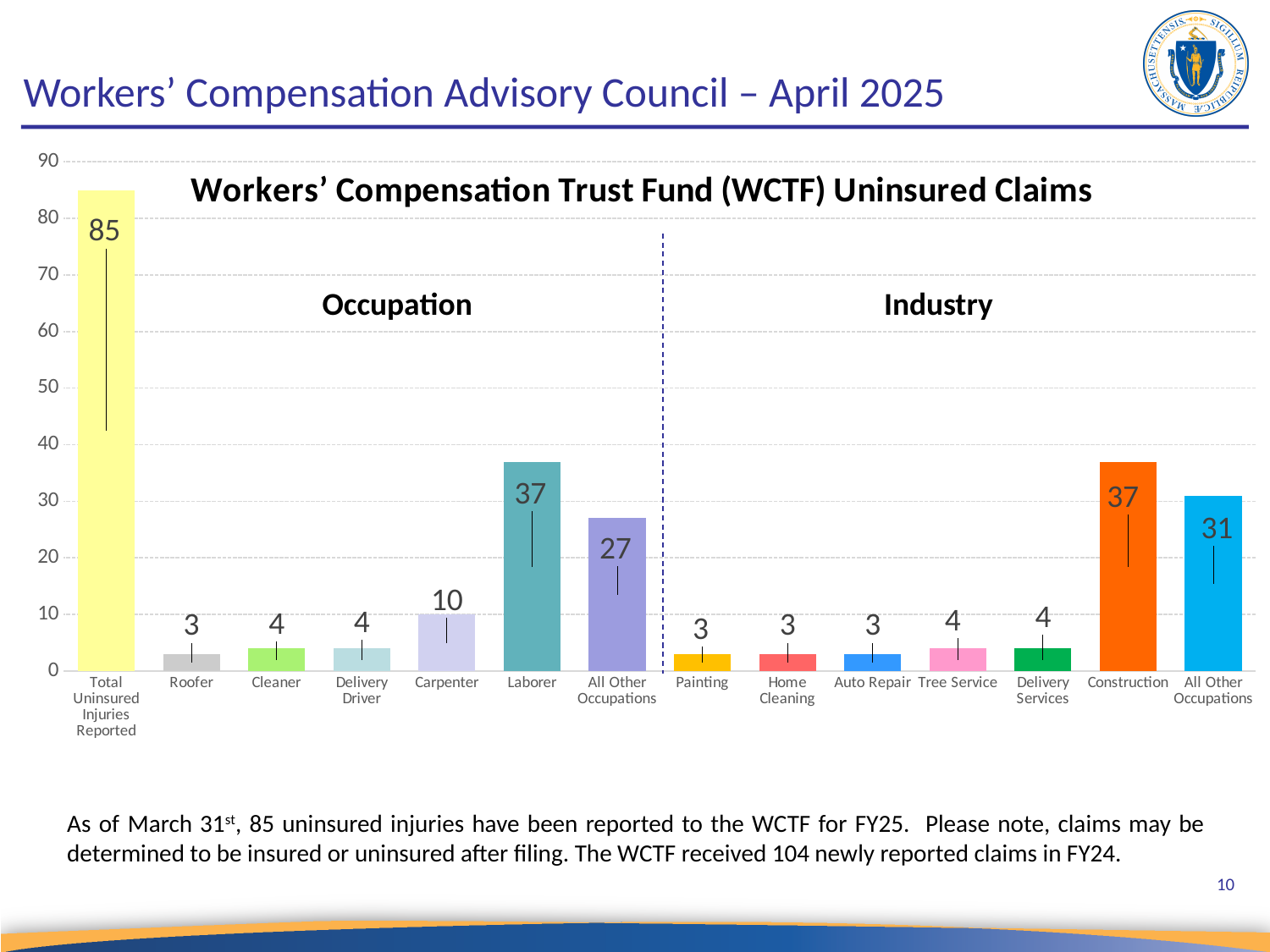
What is the title of the chart? Workers' Compensation Trust Fund (WCTF) Uninsured Claims What is the value for Laborer in the Occupation section? 37 What is the value for Construction in the Industry section? 37 Which is larger, the value for Construction or the value for All Other Occupations in the Industry section? Construction What is the value for Carpenter? 10 How many bars are plotted on the chart? 14 What is the value for All Other Occupations in the Industry section? 31 What kind of chart is shown on the slide? Bar chart What is the difference between the values for Laborer and Carpenter? 27 Within the Occupation section, which occupation has the lowest value? Roofer What is the value for Total Uninsured Injuries Reported? 85 Which category has the highest value on the chart? Total Uninsured Injuries Reported